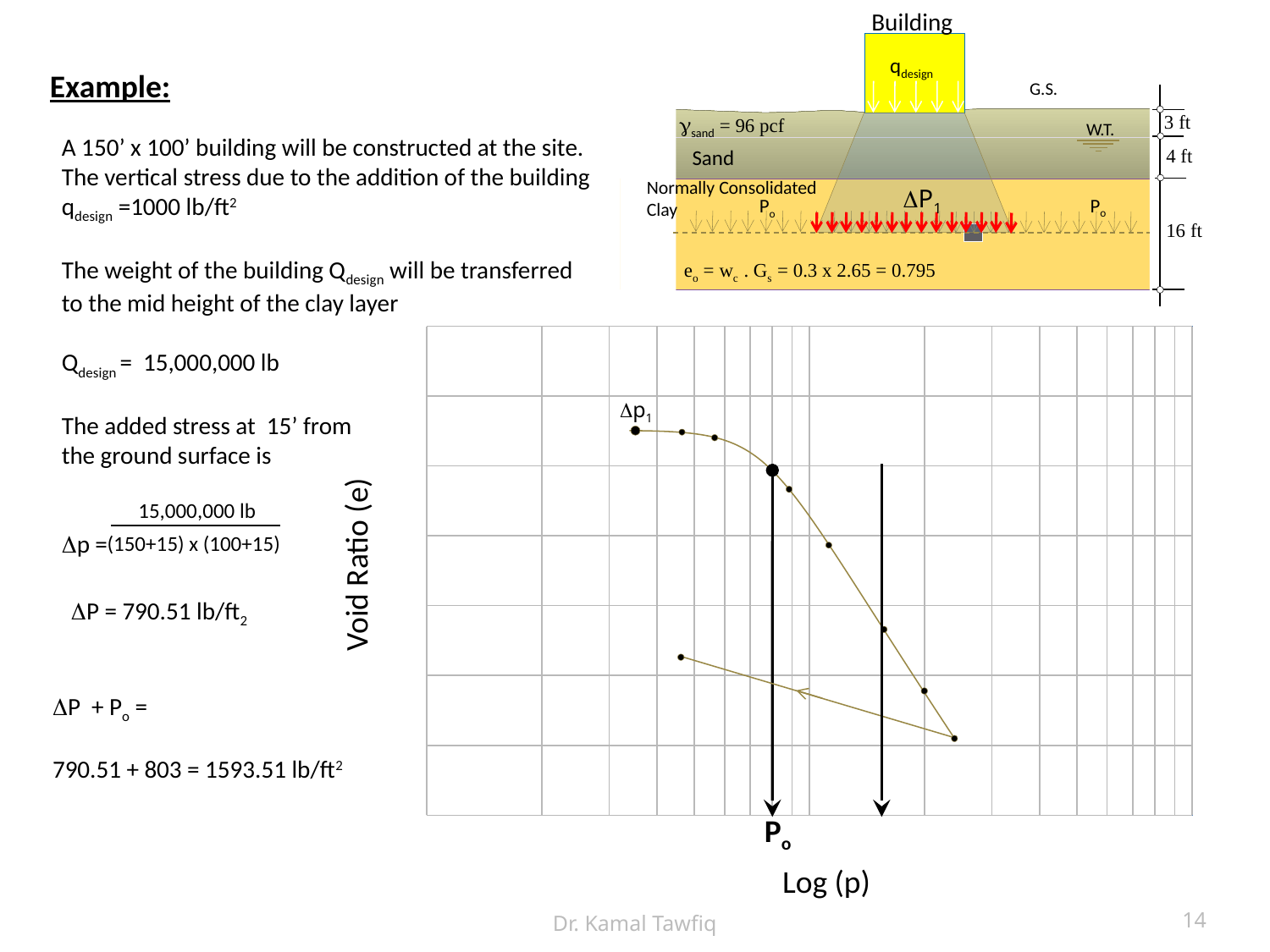
What is the label of the horizontal axis of the chart? Log (p) What is the label of the vertical axis of the chart? Void Ratio (e) Which labelled point on the curve has the highest void ratio? ΔP1 What kind of chart is shown on the slide? line chart Which labelled point on the curve has the higher void ratio, ΔP1 or Po? ΔP1 Does the void ratio rise or fall as Log (p) increases along the main curve? fall